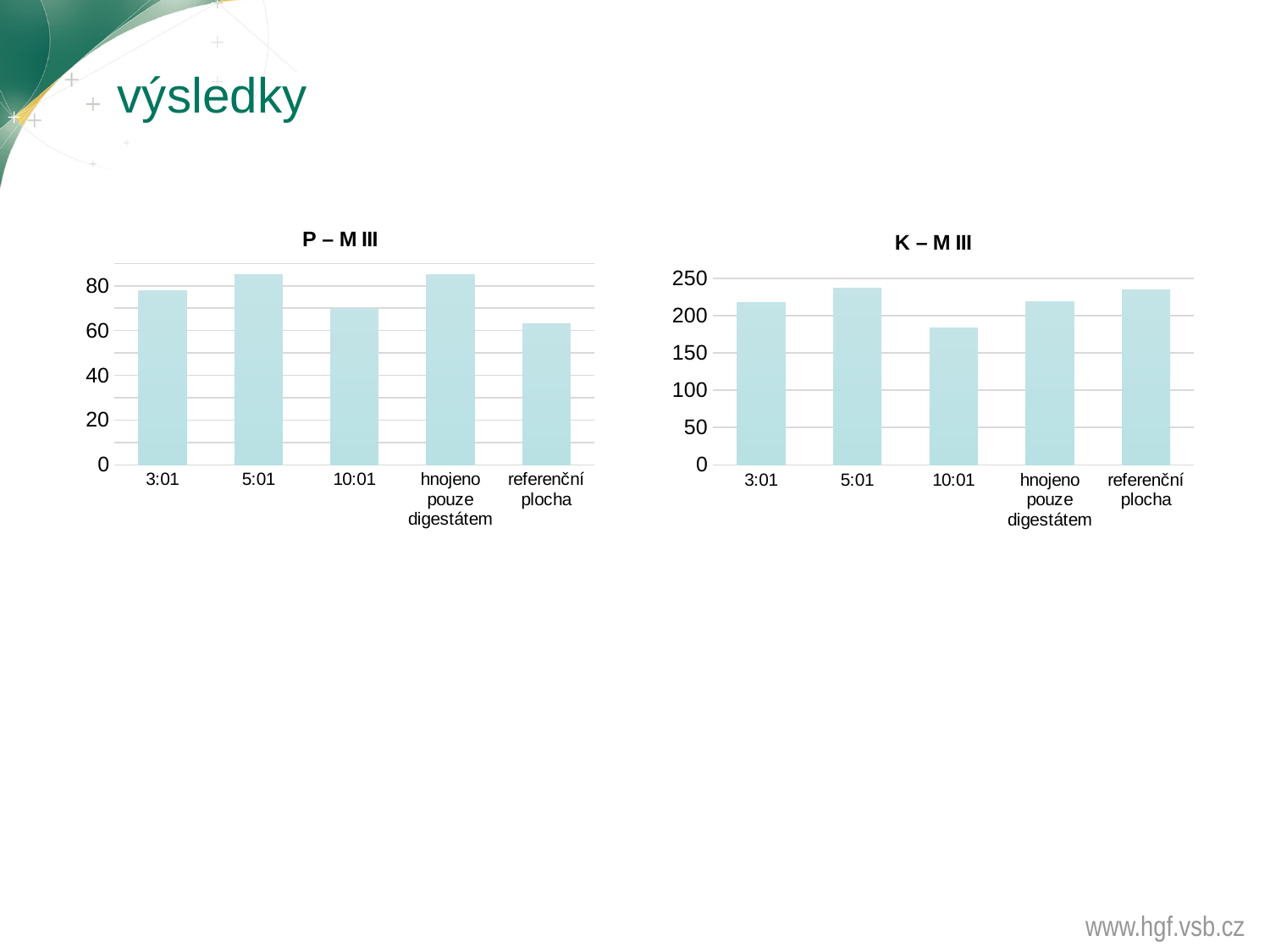
In the chart titled "K – M III", which category has the lowest value? 10:01 In the chart titled "P – M III", how many categories are shown on the x axis? 5 What kind of chart is the chart titled "P – M III"? bar chart In the chart titled "K – M III", how many bars are plotted? 5 In the chart titled "P – M III", which is larger, the value for 3:01 or the value for 10:01? 3:01 In the chart titled "P – M III", is the value for 3:01 greater or less than 60? greater In the chart titled "P – M III", which category has the lowest value? referenční plocha In the chart titled "K – M III", is the value for 10:01 greater or less than 200? less What is the title of the chart on the right side of the slide? K – M III In the chart titled "P – M III", is the value for 10:01 greater or less than 80? less In the chart titled "K – M III", which is larger, the value for 3:01 or the value for 10:01? 3:01